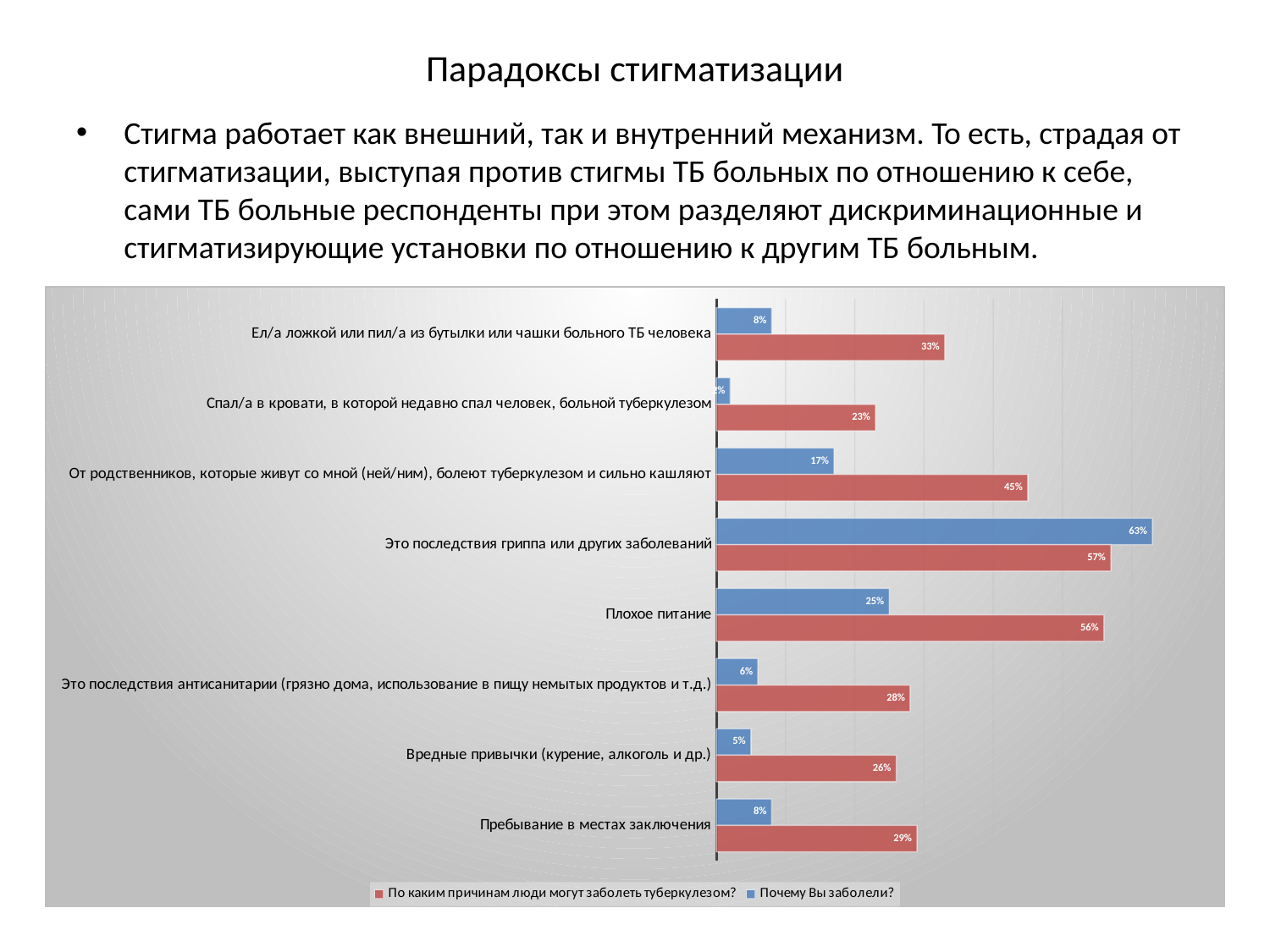
What kind of chart is shown on the slide? Bar chart Which category has the lowest value in the series "По каким причинам люди могут заболеть туберкулезом?"? Спал/а в кровати, в которой недавно спал человек, больной туберкулезом For "Это последствия гриппа или других заболеваний", which series has the larger value? Почему Вы заболели? What colour are the bars for the series "Почему Вы заболели?"? Blue How many series does the legend list? 2 For "Вредные привычки (курение, алкоголь и др.)", which series has the larger value? По каким причинам люди могут заболеть туберкулезом? What is the value for "Пребывание в местах заключения" in the series "По каким причинам люди могут заболеть туберкулезом?"? 29% Which category has the highest value in the series "Почему Вы заболели?"? Это последствия гриппа или других заболеваний What is the value for "Это последствия гриппа или других заболеваний" in the series "Почему Вы заболели?"? 63% How many categories are shown on the chart? 8 What is the difference between the two series for "От родственников, которые живут со мной (ней/ним), болеют туберкулезом и сильно кашляют"? 28% What is the value for "Плохое питание" in the series "По каким причинам люди могут заболеть туберкулезом?"? 56%